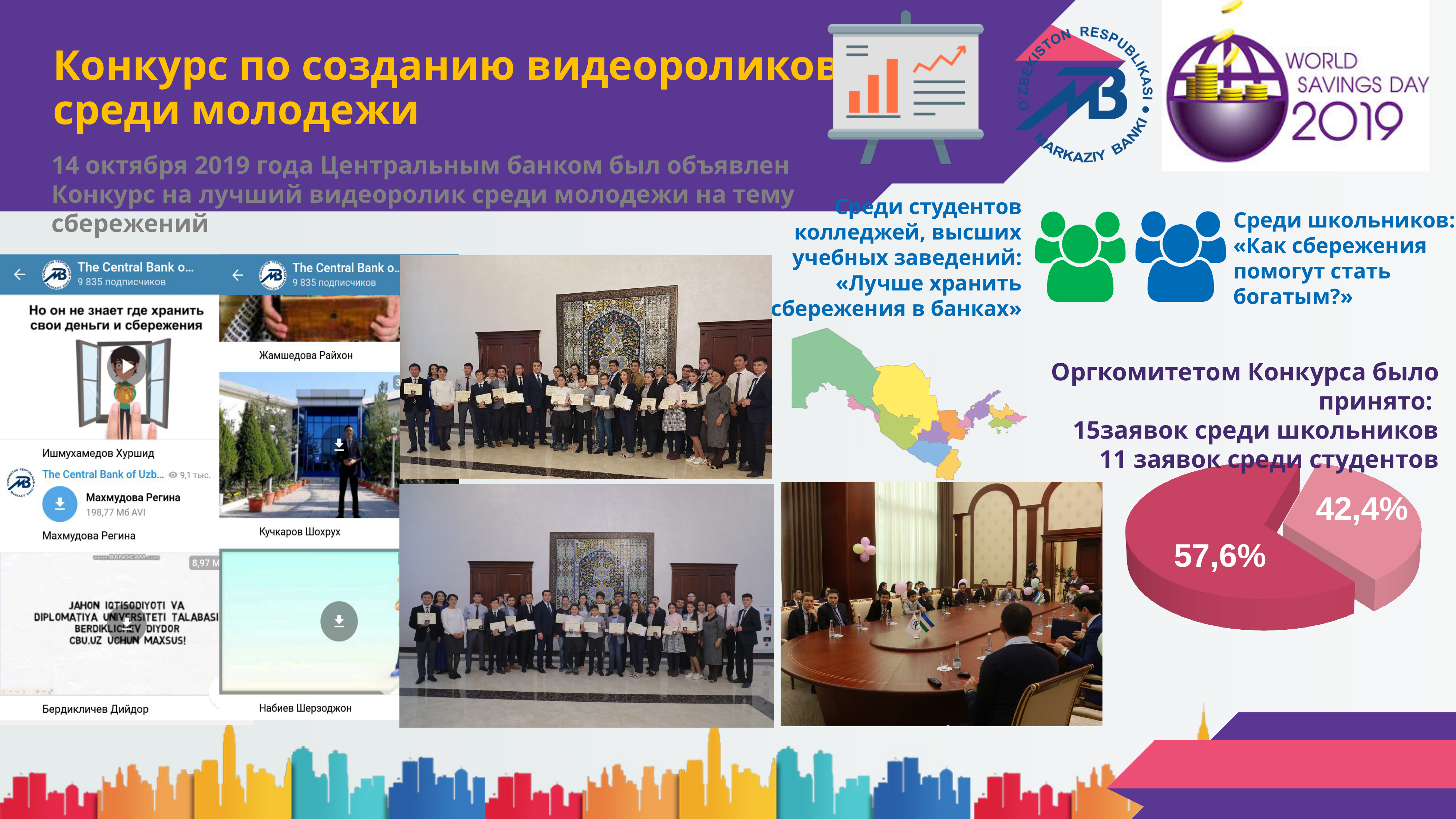
Does the pie chart on the slide have a legend? No What is the value of the smallest slice in the pie chart? 42,4% Is the larger slice of the pie chart greater or less than 50%? greater What kind of chart is shown at the bottom right of the slide? pie chart In the pie chart, which slice is larger: the one labelled 57,6% or the one labelled 42,4%? 57,6% Is the smaller slice of the pie chart greater or less than 50%? less Which slice of the pie chart is pulled out (exploded) from the rest: the 57,6% slice or the 42,4% slice? 42,4% What is the value of the largest slice in the pie chart? 57,6% How many slices does the pie chart at the bottom right have? 2 In the pie chart, what is the difference between the two slices' values? 15,2%